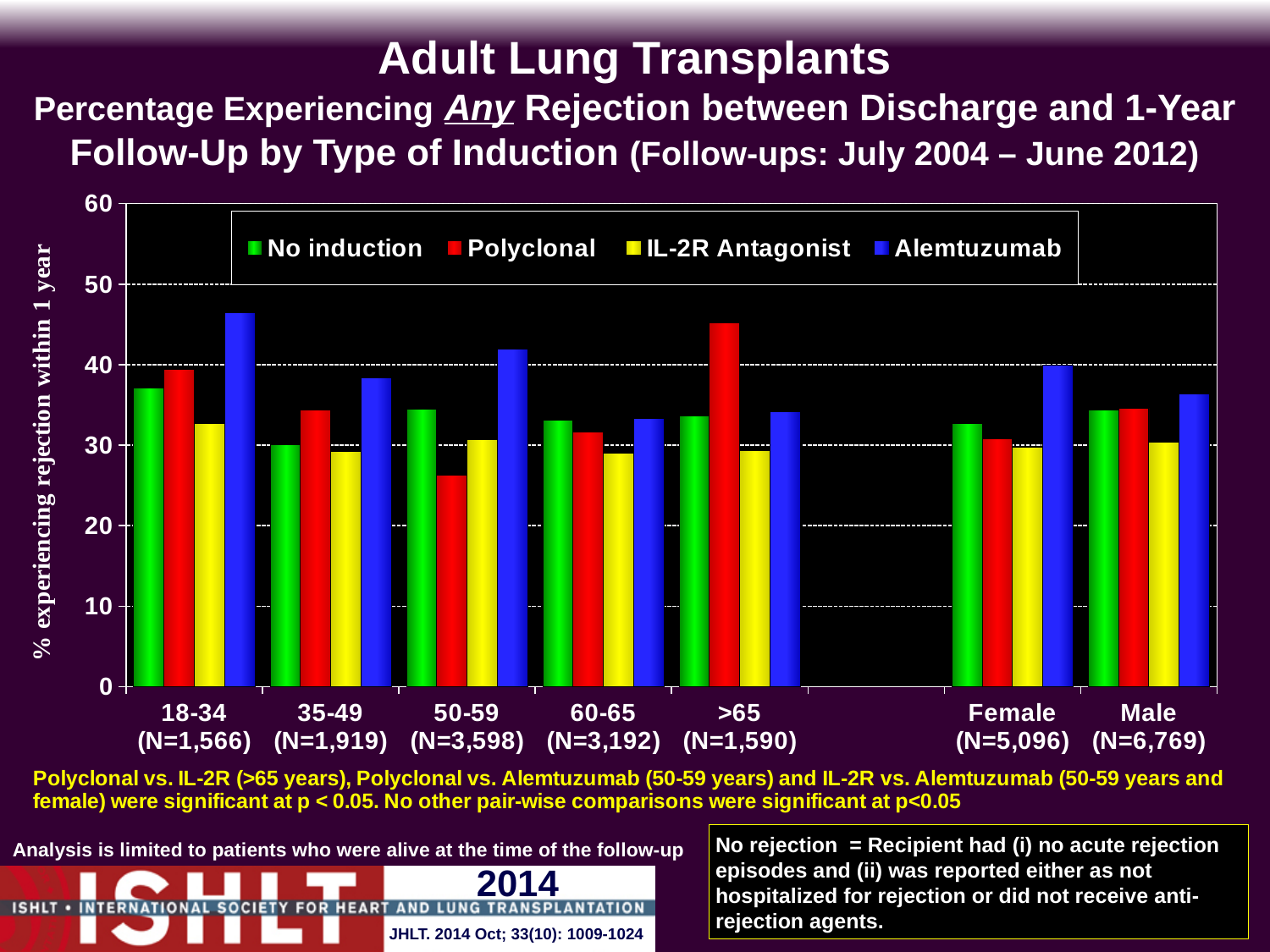
For Alemtuzumab, which is larger: Female or Male? Female Is the value for No induction in the 35-49 age group greater or less than 40? less Is the value for Alemtuzumab in the 18-34 age group greater or less than 40? greater Which induction type has the lowest percentage in the 50-59 age group? Polyclonal In the >65 age group, which is larger: Polyclonal or IL-2R Antagonist? Polyclonal Is the value for Polyclonal in the 50-59 age group greater or less than 30? less How many categories are shown along the x axis? 7 What colour represents Alemtuzumab in the legend? Blue What kind of chart is shown on the slide? Bar chart Which induction type has the highest percentage in the 18-34 age group? Alemtuzumab How many induction types does the legend list? 4